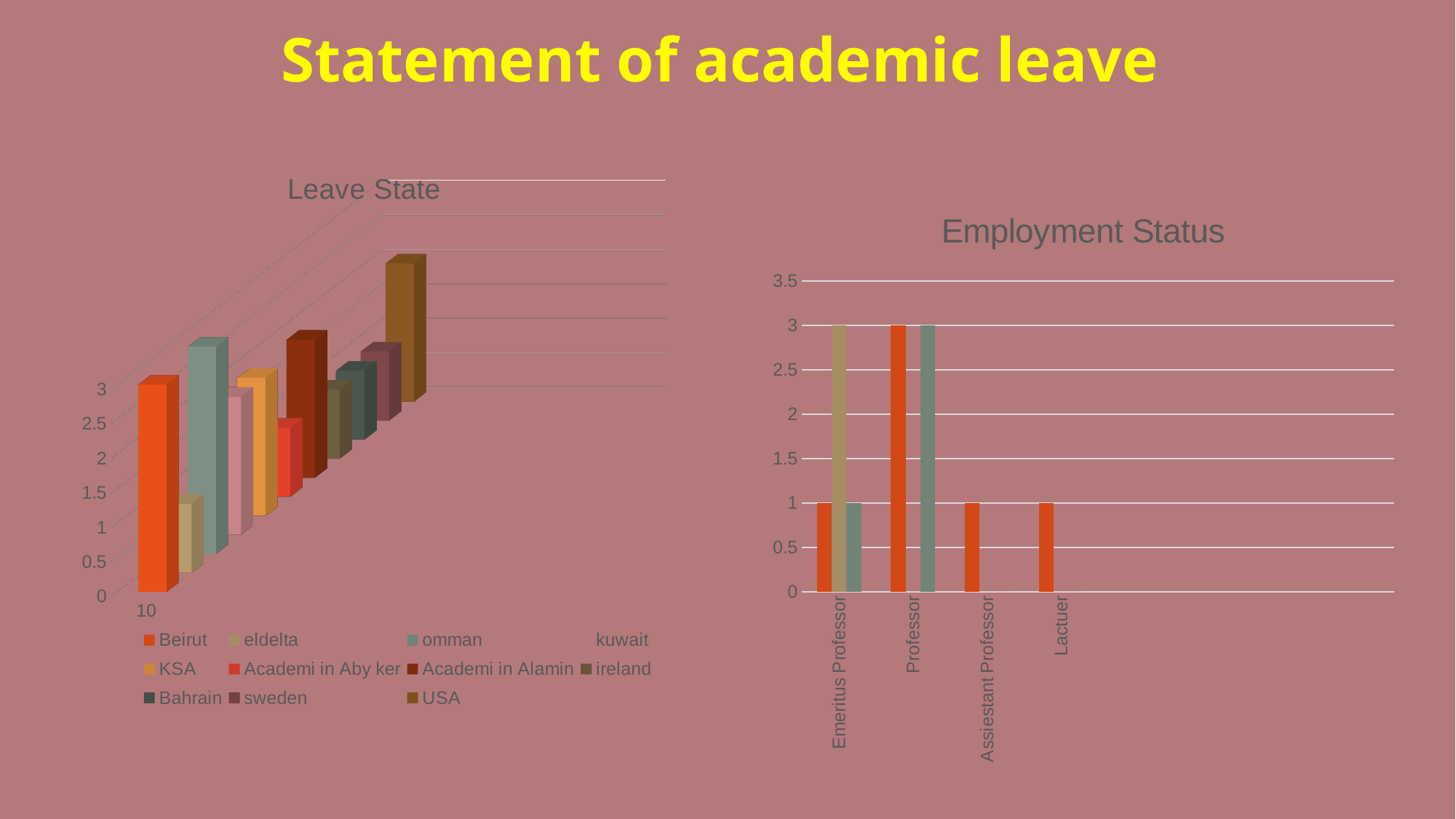
In the Employment Status chart, which is larger: the bar for Lactuer or the bars for Professor? Professor In the Employment Status chart, how many bars are shown for Emeritus Professor? 3 How many series does the legend of the Leave State chart list? 11 In the Employment Status chart, what is the value of the bar for Lactuer? 1 What is the title of the chart on the right of the slide? Employment Status What is the title of the chart on the left of the slide? Leave State In the Employment Status chart, what value does the tallest bar for Emeritus Professor reach? 3 What kind of chart is the Employment Status chart on the right? bar chart In the Employment Status chart, is the value for Lactuer greater or less than 2? less How many categories are shown on the x axis of the Employment Status chart? 4 In the Employment Status chart, what is the value of the bar for Assiestant Professor? 1